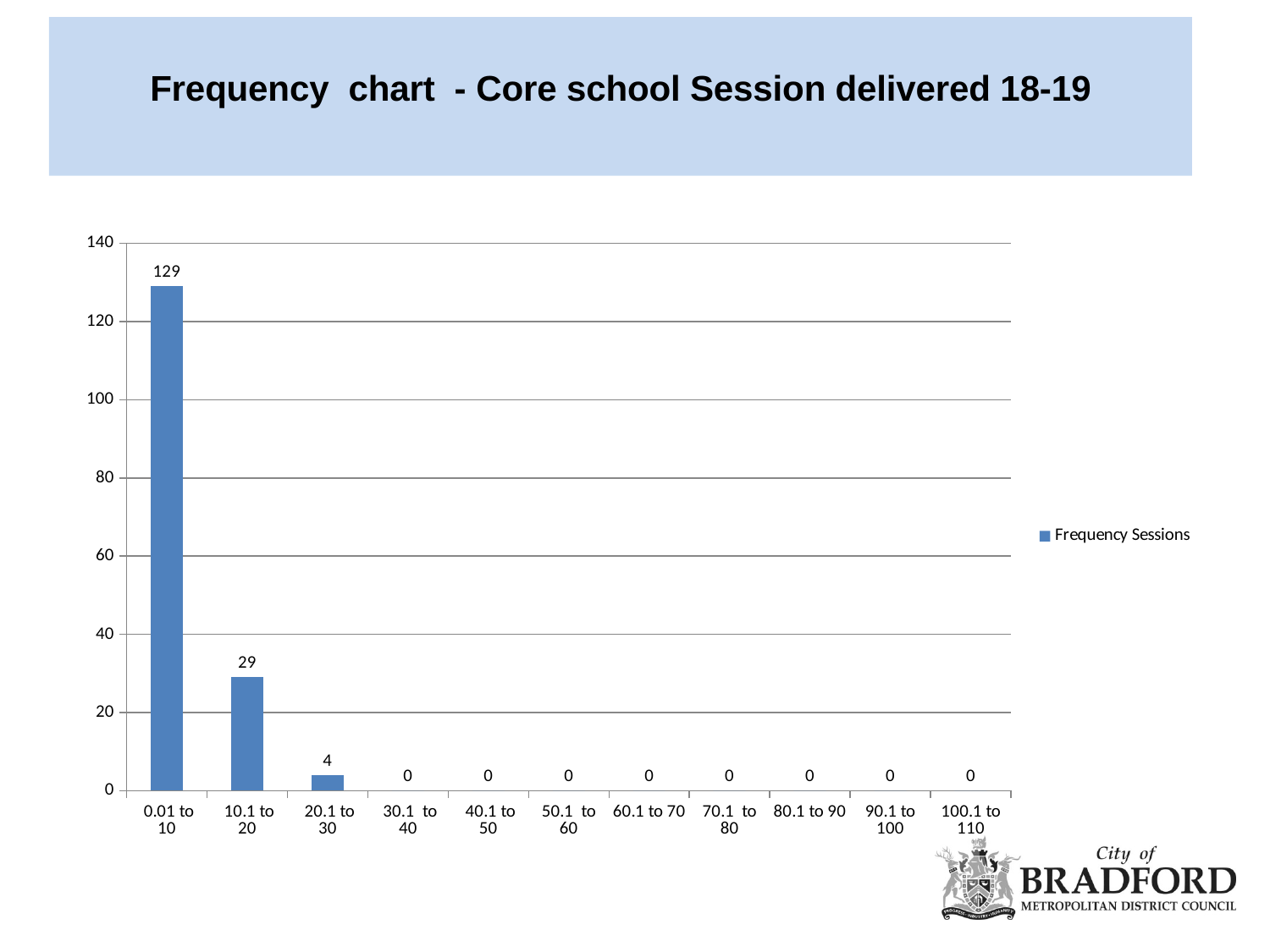
What is the difference between the values for 10.1 to 20 and 20.1 to 30? 25 What series name is listed in the legend? Frequency Sessions Which is larger, the value for 10.1 to 20 or the value for 20.1 to 30? 10.1 to 20 What is the value for the 20.1 to 30 category? 4 Is the value for 0.01 to 10 greater or less than 120? greater What is the value for the 0.01 to 10 category? 129 Which category has the highest value? 0.01 to 10 What is the value for the 60.1 to 70 category? 0 What is the difference between the values for 0.01 to 10 and 10.1 to 20? 100 How many categories are shown on the x axis? 11 What kind of chart is shown on the slide? bar chart What is the value for the 10.1 to 20 category? 29